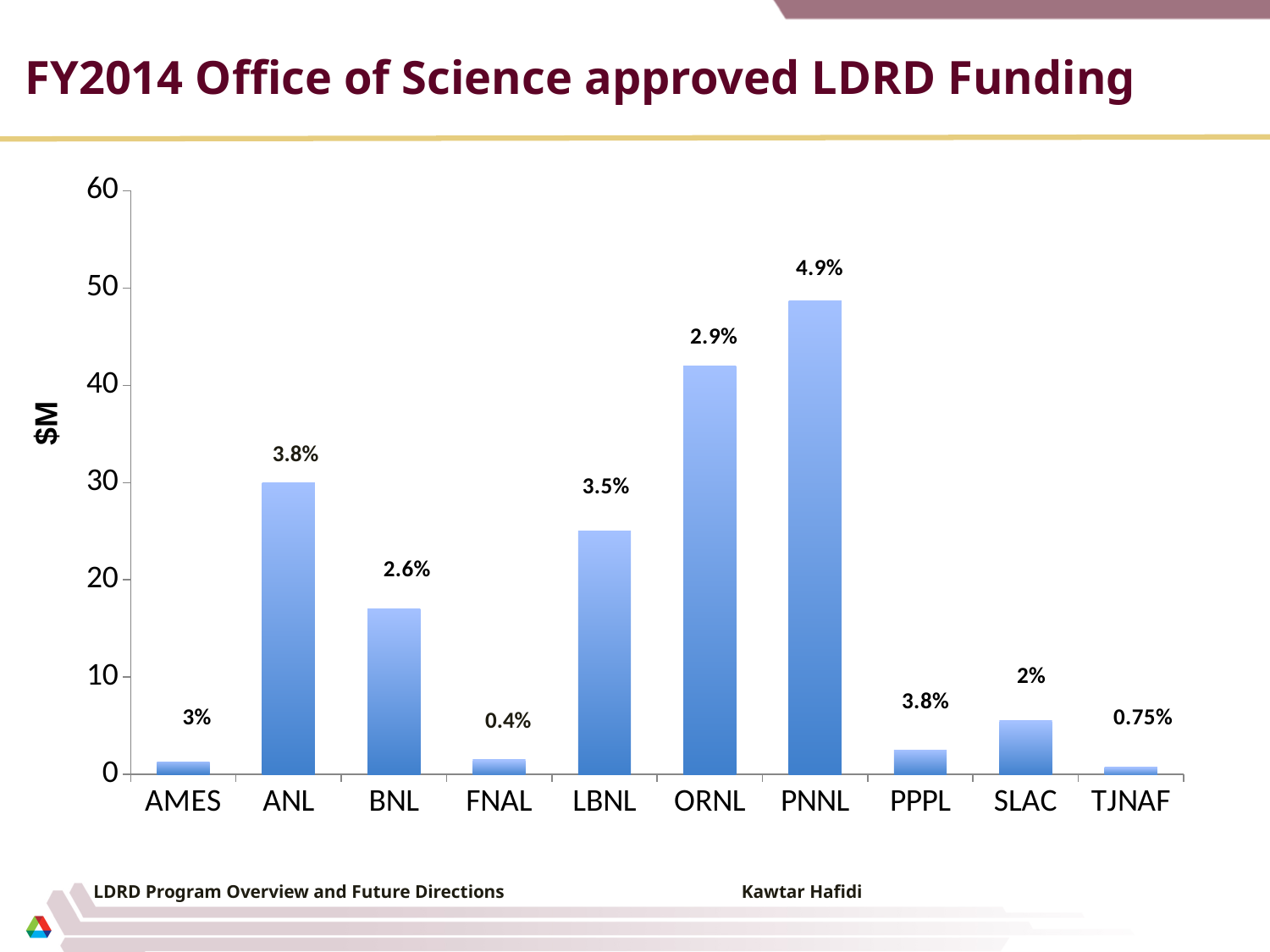
What percentage label is printed above the PNNL bar? 4.9% What is the label on the y axis? $M What kind of chart is shown on the slide? bar chart Which laboratory has the lowest bar? TJNAF Which laboratory has the highest bar? PNNL What percentage label is printed above the FNAL bar? 0.4% Is the value for BNL greater or less than 20? less What percentage label is printed above the TJNAF bar? 0.75% What percentage label is printed above the BNL bar? 2.6% Which bar is taller, ORNL or LBNL? ORNL Is the value for ORNL greater or less than 40? greater How many laboratories (categories) are shown on the x axis? 10